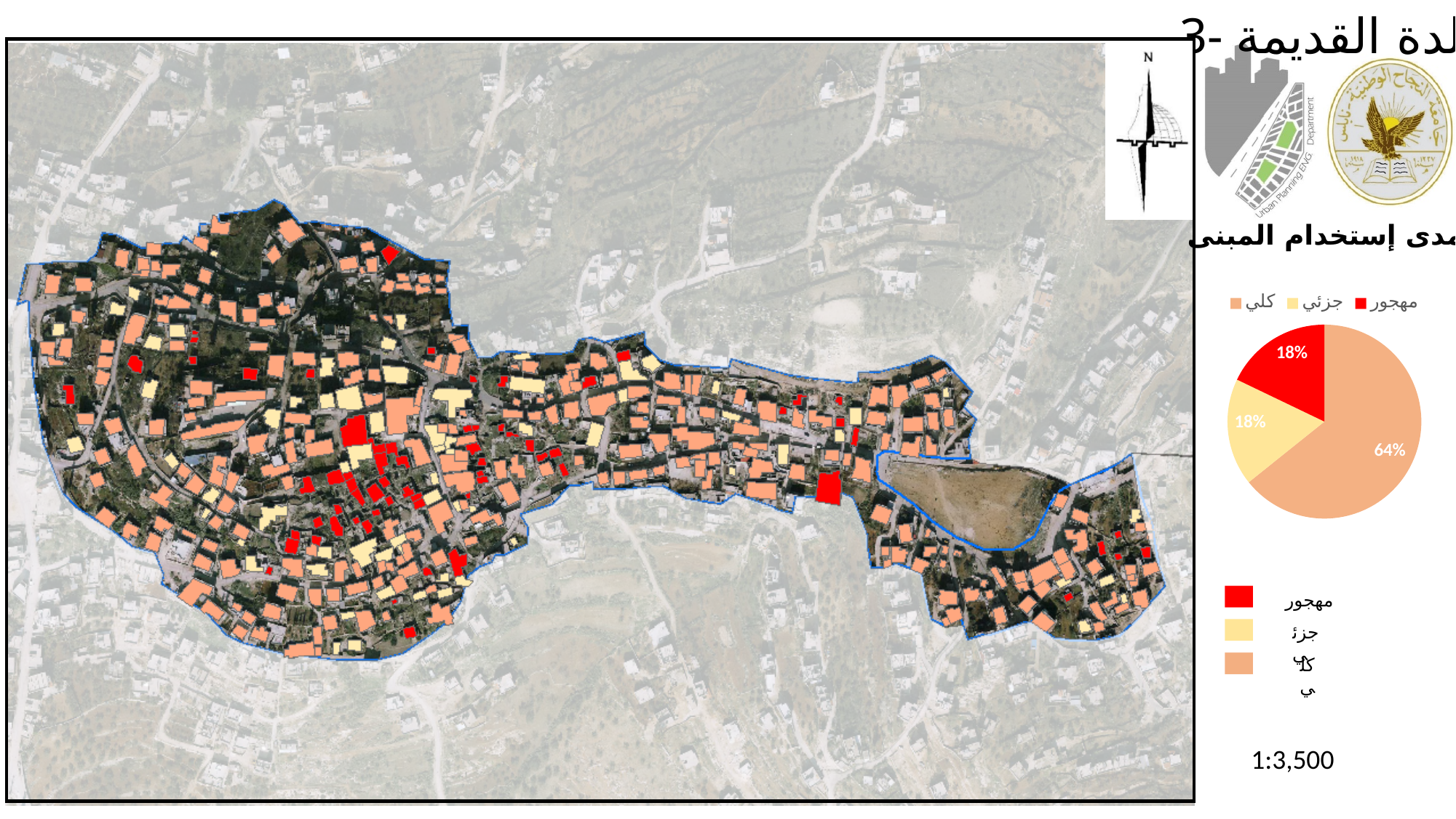
What kind of chart is shown on the right side of the slide? pie chart What colour is the كلي slice in the pie chart? orange In the pie chart, which is larger: the share for كلي or the share for جزئي? كلي Which category has the largest slice in the pie chart? كلي In the pie chart, what share is shown for كلي? 64% What colour is the مهجور slice in the pie chart? red In the pie chart, what share is shown for جزئي? 18% Is the share for كلي in the pie chart greater or less than 50%? greater How many slices does the pie chart have? 3 How many entries does the pie chart legend list? 3 What is the difference between the share for كلي and the share for مهجور in the pie chart? 46% In the pie chart, what share is shown for مهجور? 18%